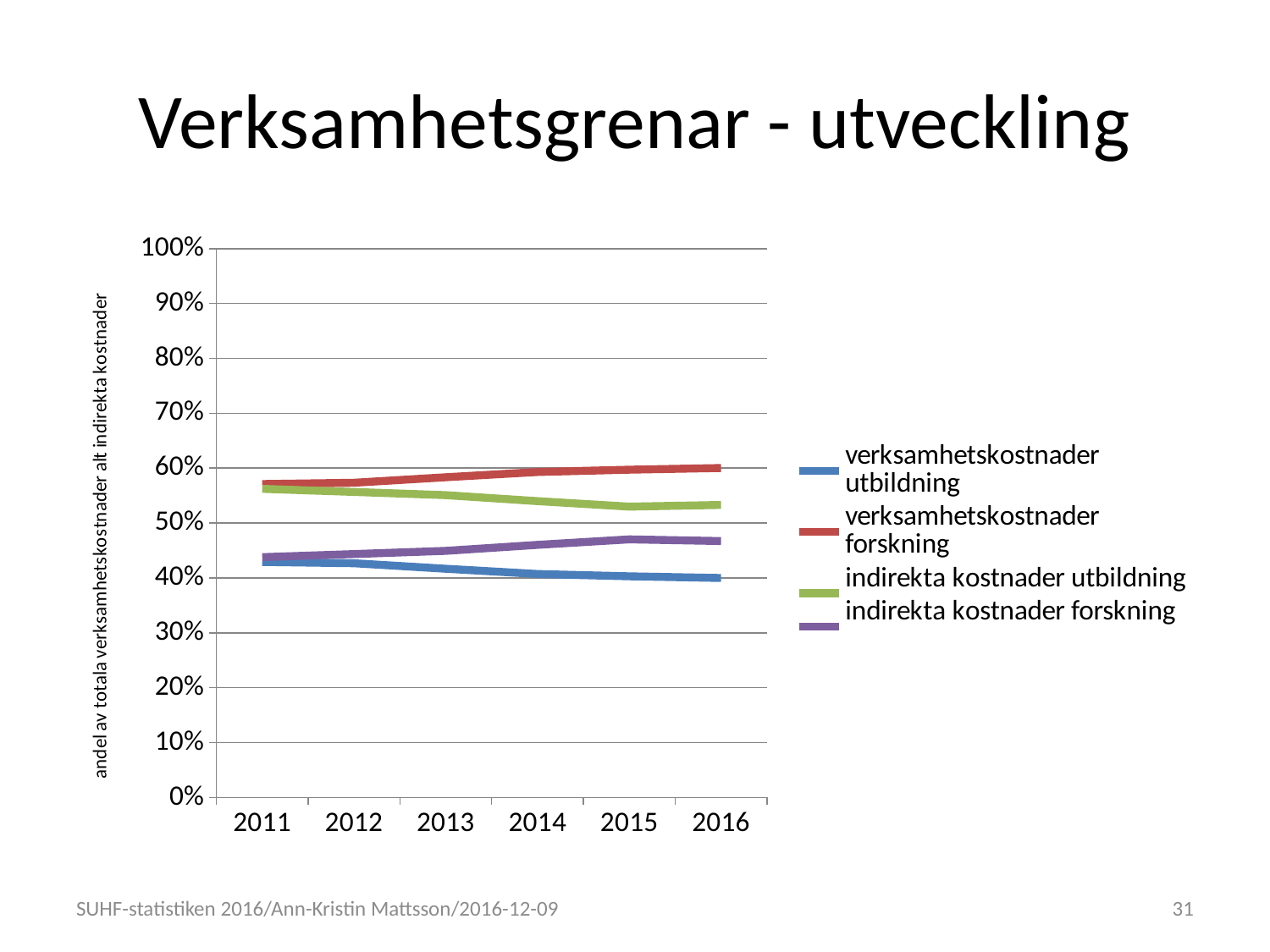
Is the value for indirekta kostnader forskning in 2011 greater or less than 50%? less What kind of chart is shown on the slide? line chart Does the value for indirekta kostnader utbildning rise or fall from 2011 to 2016? fall Is the value for verksamhetskostnader forskning in 2016 greater or less than 50%? greater Does the value for verksamhetskostnader utbildning rise or fall from 2011 to 2016? fall In 2011, which is larger: indirekta kostnader utbildning or indirekta kostnader forskning? indirekta kostnader utbildning How many years are shown on the x axis? 6 Which colour is used for the indirekta kostnader forskning series? purple In 2016, which is larger: verksamhetskostnader forskning or verksamhetskostnader utbildning? verksamhetskostnader forskning Does the value for verksamhetskostnader forskning rise or fall from 2011 to 2016? rise How many series does the legend list? 4 Is the value for verksamhetskostnader utbildning in 2016 greater or less than 50%? less